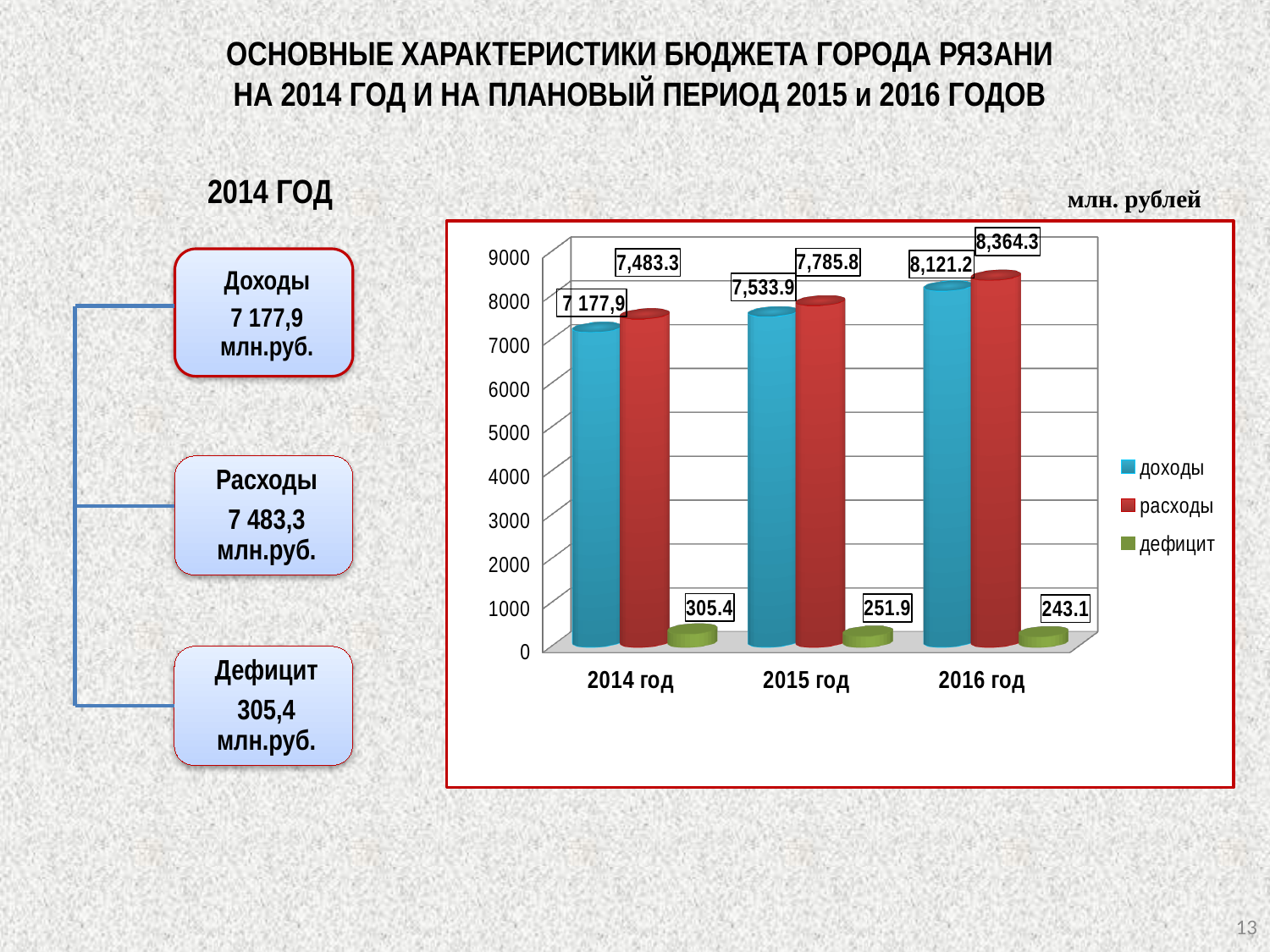
What is the value of доходы for 2015 год? 7,533.9 How many series does the legend list? 3 Which is larger for 2015 год: доходы or расходы? расходы Do the values of расходы rise or fall from 2014 год to 2016 год? rise In which year is доходы the highest? 2016 год What kind of chart is shown on the slide? bar chart What is the difference between расходы and доходы for 2016 год? 243.1 What is the value of дефицит for 2014 год? 305.4 In which year is дефицит the lowest? 2016 год What is the value of расходы for 2015 год? 7,785.8 What is the difference between дефицит in 2014 год and дефицит in 2016 год? 62.3 What is the value of расходы for 2016 год? 8,364.3